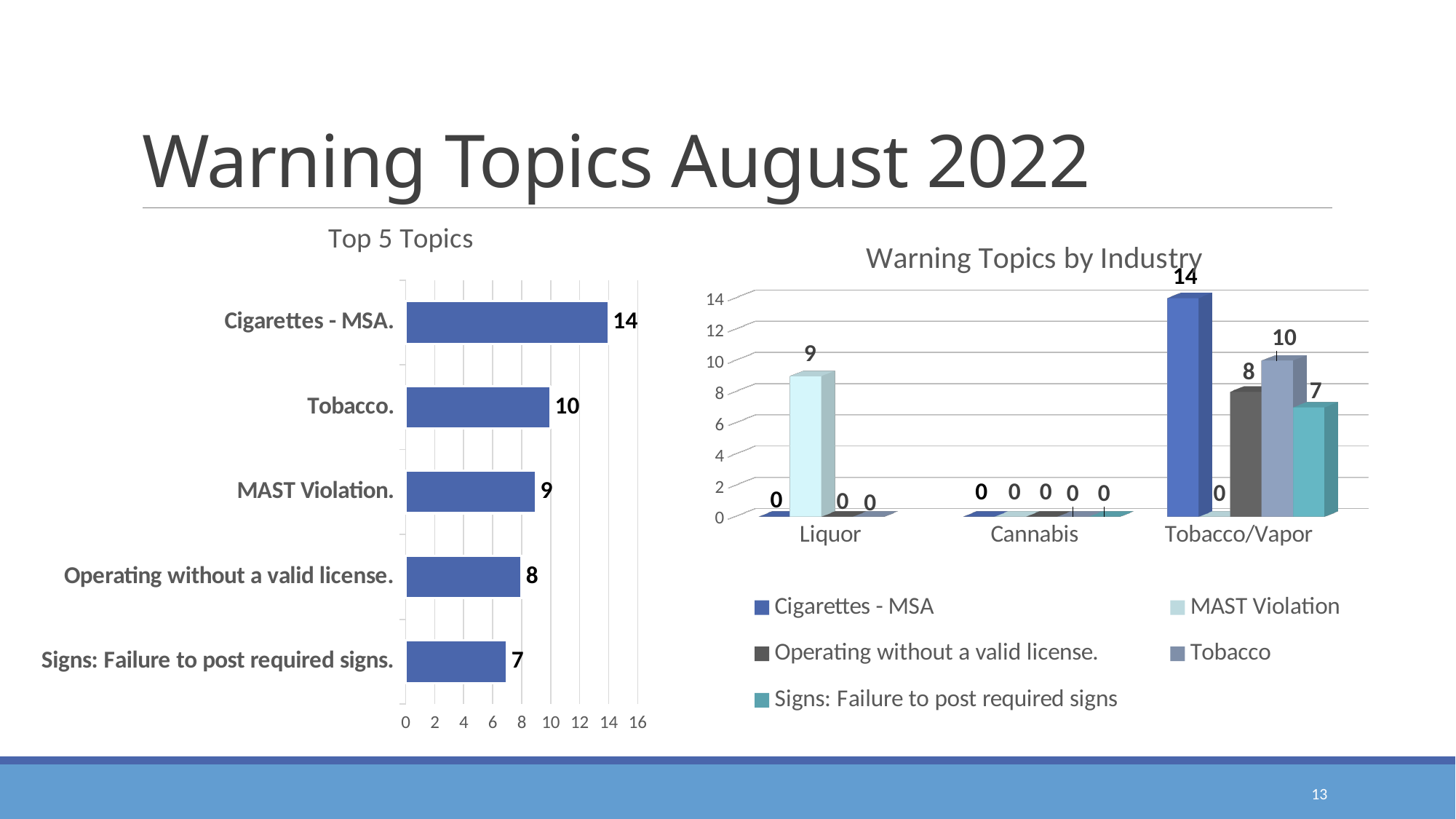
In the 'Warning Topics by Industry' chart, how many industries are shown on the x axis? 3 In the 'Warning Topics by Industry' chart, what is the value for Cigarettes - MSA in the Tobacco/Vapor industry? 14 In the 'Warning Topics by Industry' chart, which is larger in the Tobacco/Vapor industry: Tobacco or Operating without a valid license? Tobacco In the 'Warning Topics by Industry' chart, what is the value for Signs: Failure to post required signs in the Cannabis industry? 0 In the 'Warning Topics by Industry' chart, how many series does the legend list? 5 In the 'Top 5 Topics' chart, what is the value for Tobacco? 10 In the 'Top 5 Topics' chart, which topic has the highest value? Cigarettes - MSA. In the 'Warning Topics by Industry' chart, what is the value for MAST Violation in the Liquor industry? 9 What kind of chart is the 'Top 5 Topics' chart? Bar chart In the 'Top 5 Topics' chart, what is the difference between the values for Cigarettes - MSA and MAST Violation? 5 In the 'Top 5 Topics' chart, how many topics are shown? 5 In the 'Top 5 Topics' chart, which topic has the lowest value? Signs: Failure to post required signs.